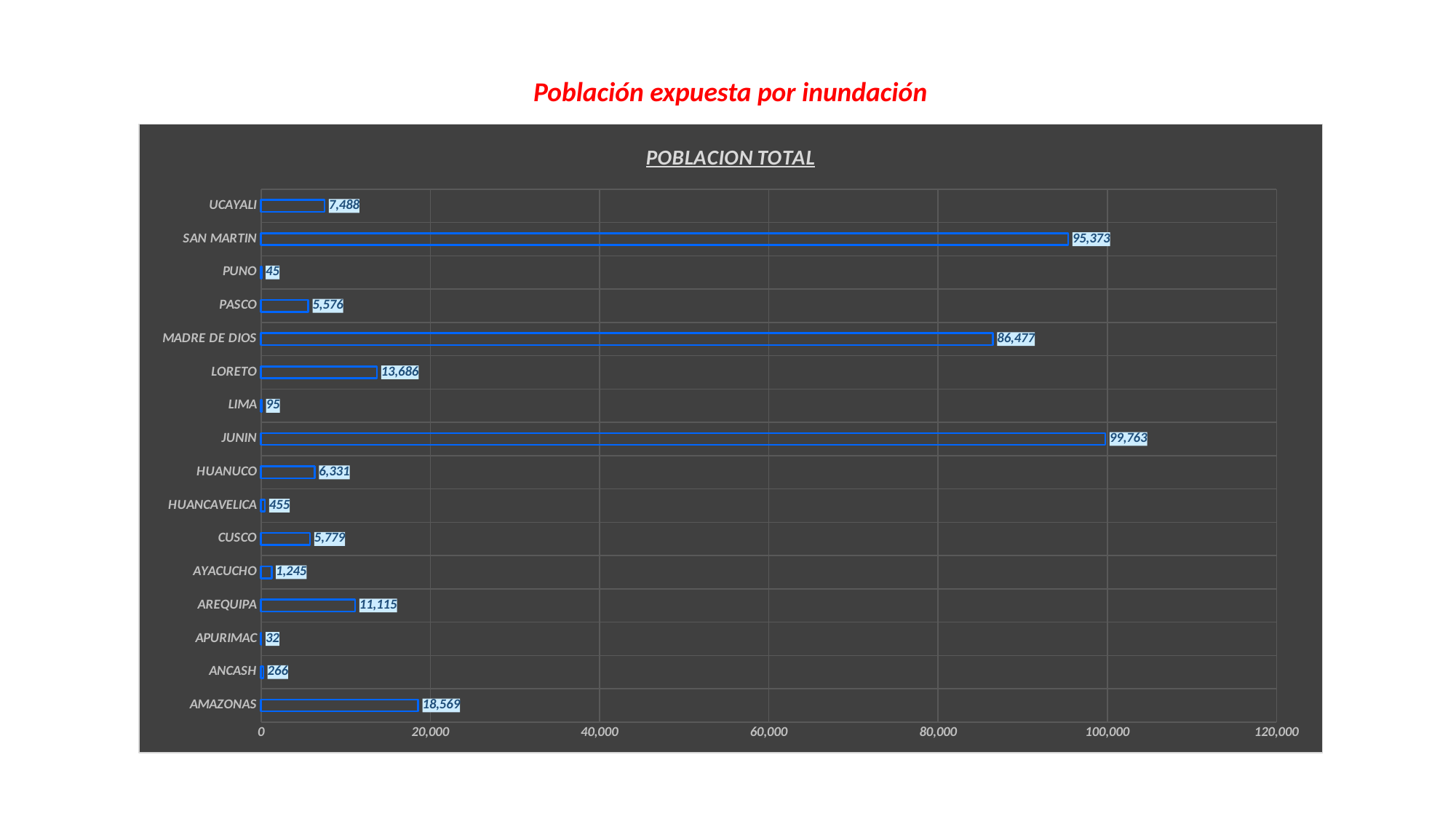
Which category has the lowest value? APURIMAC What is the value for JUNIN? 99,763 What is the difference between the values for JUNIN and SAN MARTIN? 4,390 What kind of chart is shown on the slide? bar chart What is the value for HUANCAVELICA? 455 What is the value for MADRE DE DIOS? 86,477 What is the title of the chart? POBLACION TOTAL How many categories are shown in the chart? 16 What is the value for AMAZONAS? 18,569 Is the value for SAN MARTIN greater or less than 80,000? greater Which category has the highest value? JUNIN Which is larger, the value for LORETO or the value for AREQUIPA? LORETO